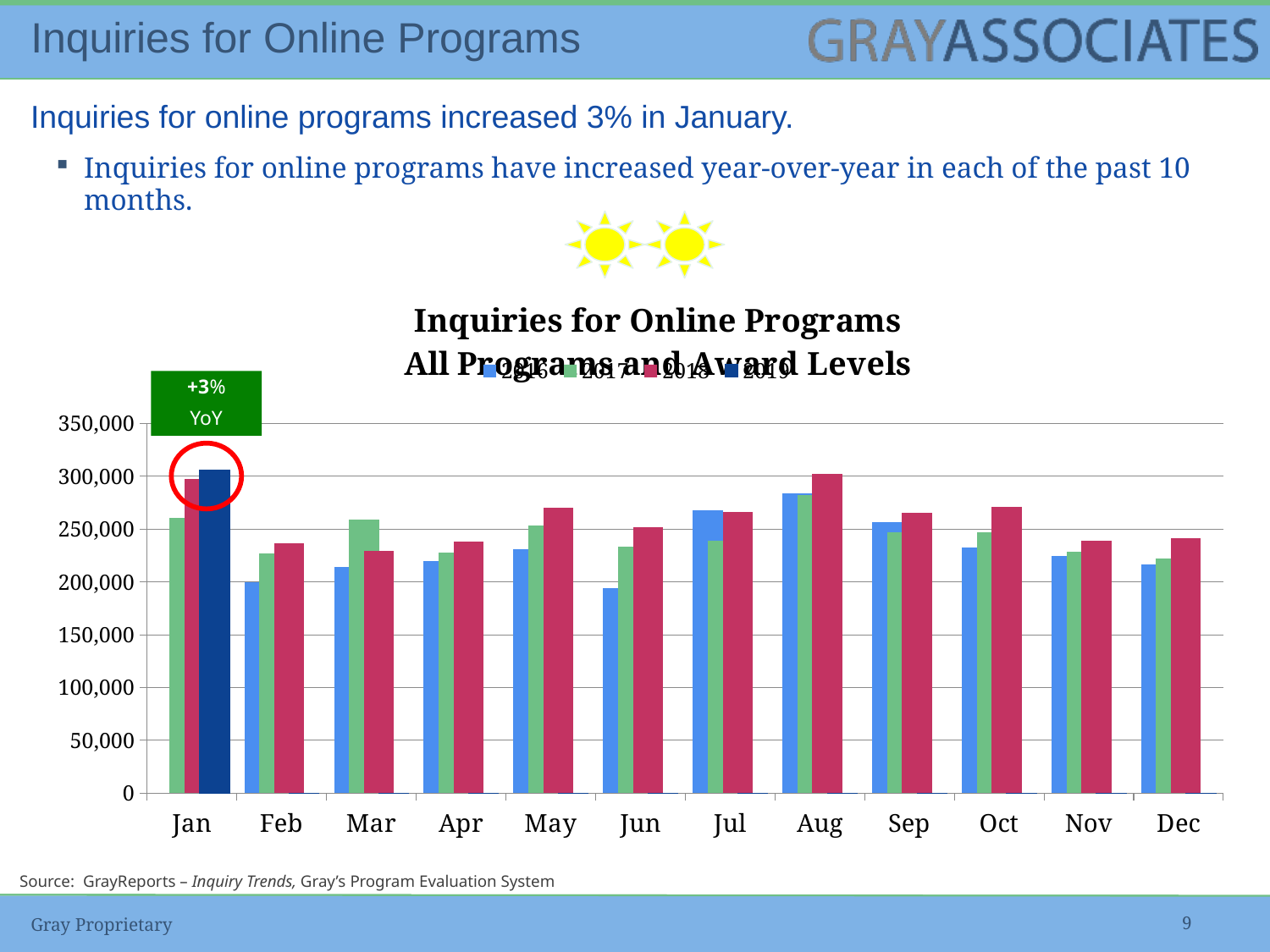
In which month is the 2016 series highest? Aug Is the value for Oct 2018 greater or less than 250,000? greater What year-over-year change is annotated above the January bars? +3% YoY Which is larger, the Jul 2016 bar or the Jul 2017 bar? Jul 2016 Is the value for Jul 2016 greater or less than 250,000? greater How many months are shown on the x axis of the chart? 12 What is the subtitle of the chart, shown below 'Inquiries for Online Programs'? All Programs and Award Levels Which is larger, the Jan 2019 bar or the Jan 2018 bar? Jan 2019 Is the value for Dec 2018 greater or less than 250,000? less What kind of chart is shown on the slide? Bar chart How many series does the chart's legend list? 4